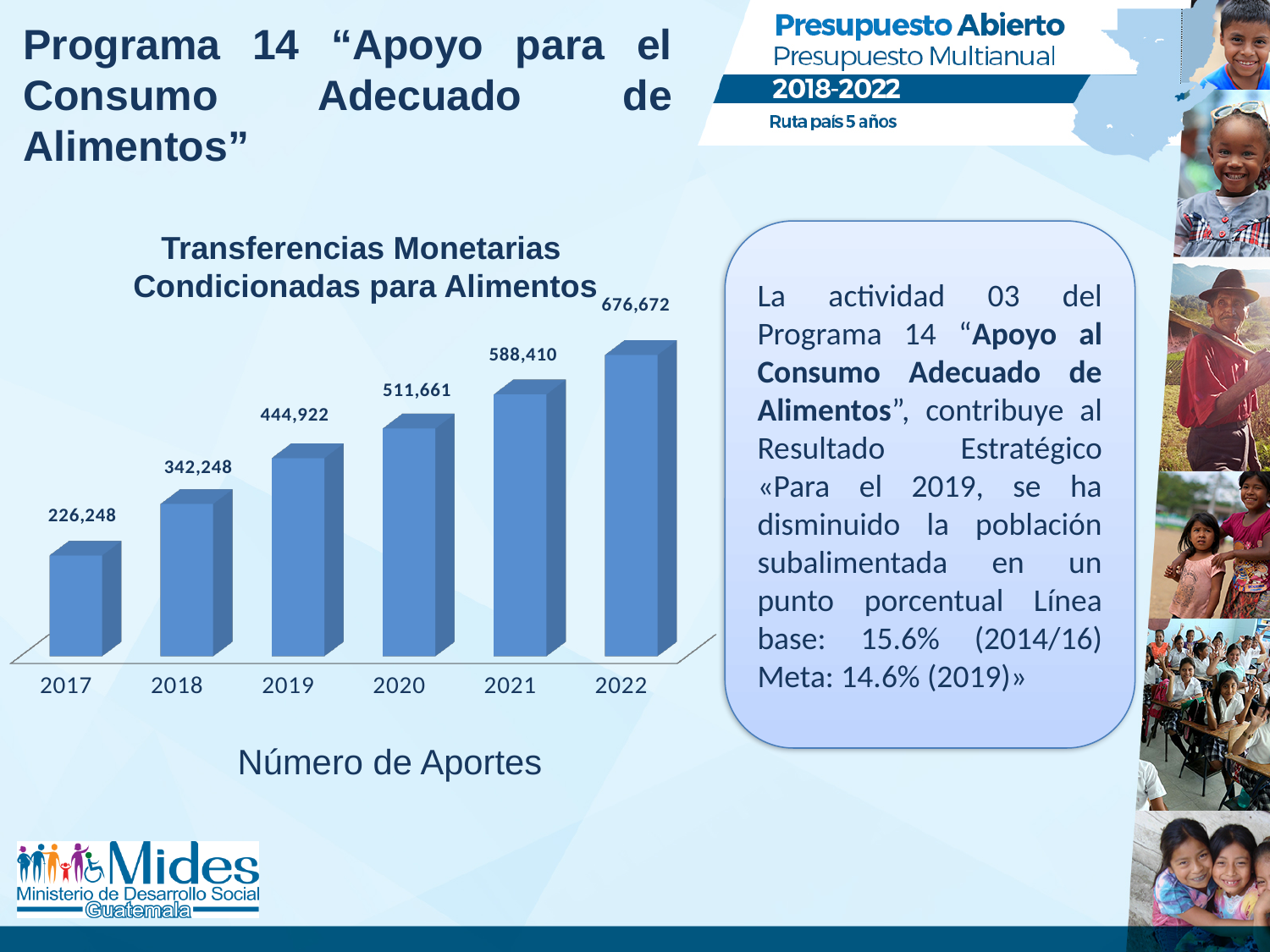
What is the value for 2022? 676,672 Which year has the highest value? 2022 Which is larger, the value for 2019 or the value for 2021? 2021 How many years are shown on the x axis? 6 Which year has the lowest value? 2017 What kind of chart is this? bar chart What is the value for 2020? 511,661 What is the value for 2017? 226,248 Do the values rise or fall from 2017 to 2022? rise What is the difference between the values for 2022 and 2021? 88,262 What is the title of the chart? Transferencias Monetarias Condicionadas para Alimentos What is the difference between the values for 2018 and 2017? 116,000